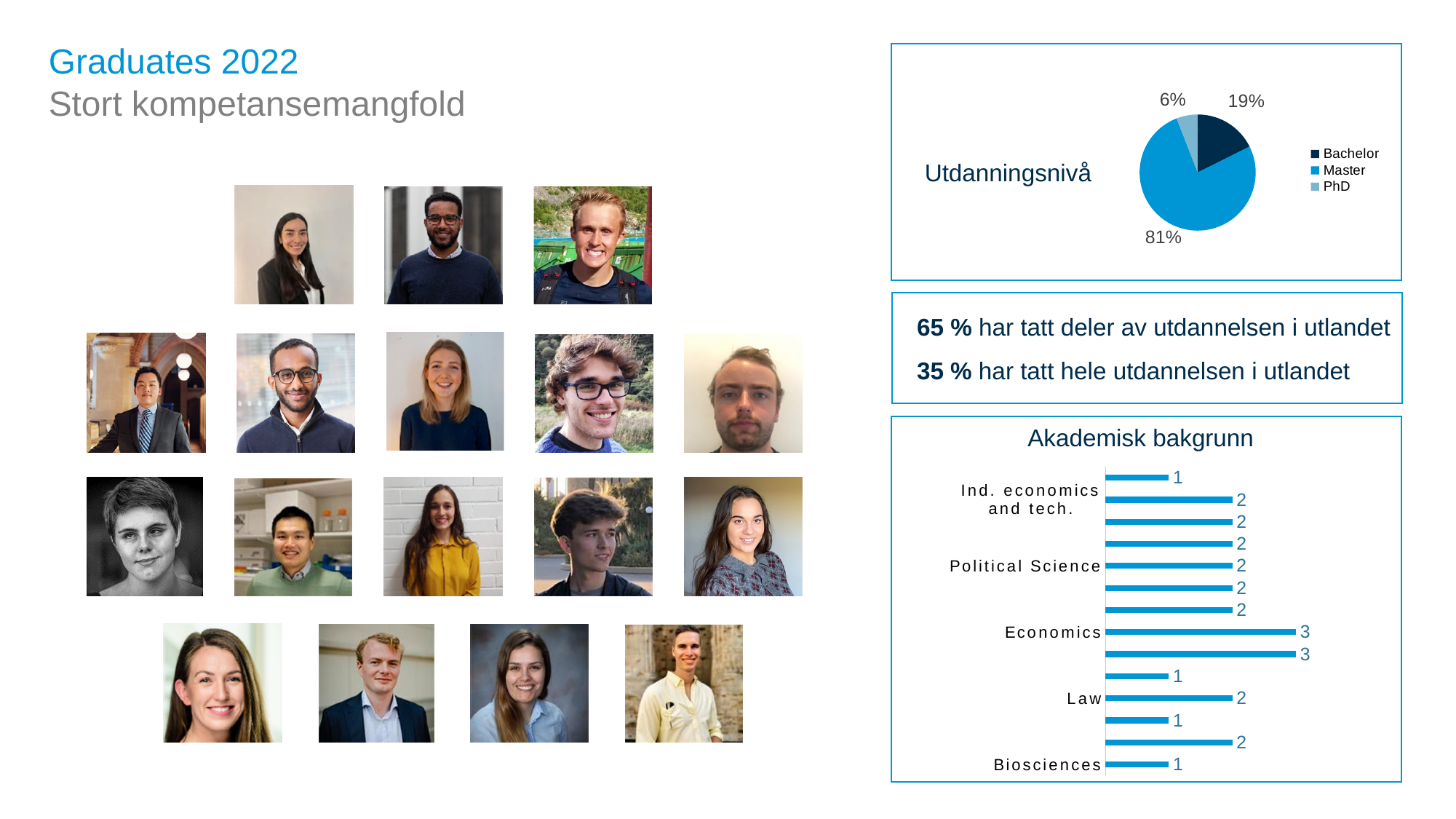
In the Utdanningsnivå pie chart, which education level has the largest share? Master In the Utdanningsnivå pie chart, what share of graduates have a Bachelor? 19% In the Utdanningsnivå pie chart, how many entries does the legend list? 3 In the Akademisk bakgrunn chart, how many bars are plotted? 14 In the Utdanningsnivå pie chart, which education level has the smallest share? PhD What kind of chart is the Akademisk bakgrunn chart? Bar chart In the Utdanningsnivå pie chart, what share of graduates have a PhD? 6% In the Utdanningsnivå pie chart, what is the difference in percentage points between the Master and Bachelor shares? 62 In the Akademisk bakgrunn chart, which is larger, the value for Political Science or the value for Biosciences? Political Science In the Akademisk bakgrunn chart, what is the value for Biosciences? 1 In the Utdanningsnivå pie chart, what share of graduates have a Master? 81% In the Akademisk bakgrunn chart, what is the value for Economics? 3